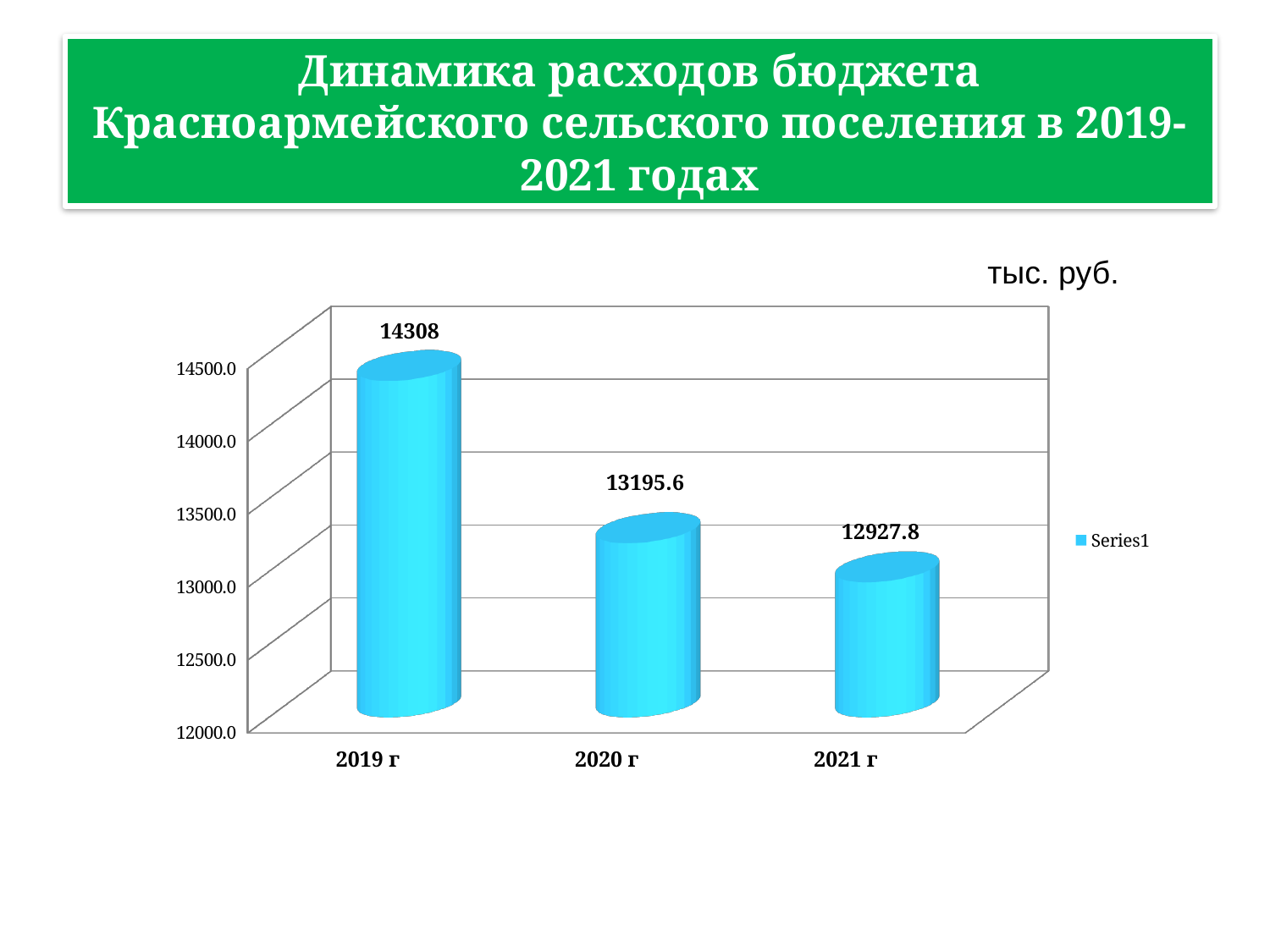
Which year has the highest value? 2019 г Which is larger, the value for 2020 г or the value for 2021 г? 2020 г What is the value for 2019 г? 14308 What kind of chart is shown on the slide? bar chart What is the difference between the values for 2020 г and 2021 г? 267.8 What is the difference between the values for 2019 г and 2020 г? 1112.4 How many years are shown on the x axis? 3 What is the value for 2021 г? 12927.8 Do the values rise or fall from 2019 г to 2021 г? fall Is the value for 2021 г greater or less than 13000.0? less What is the value for 2020 г? 13195.6 Which year has the lowest value? 2021 г